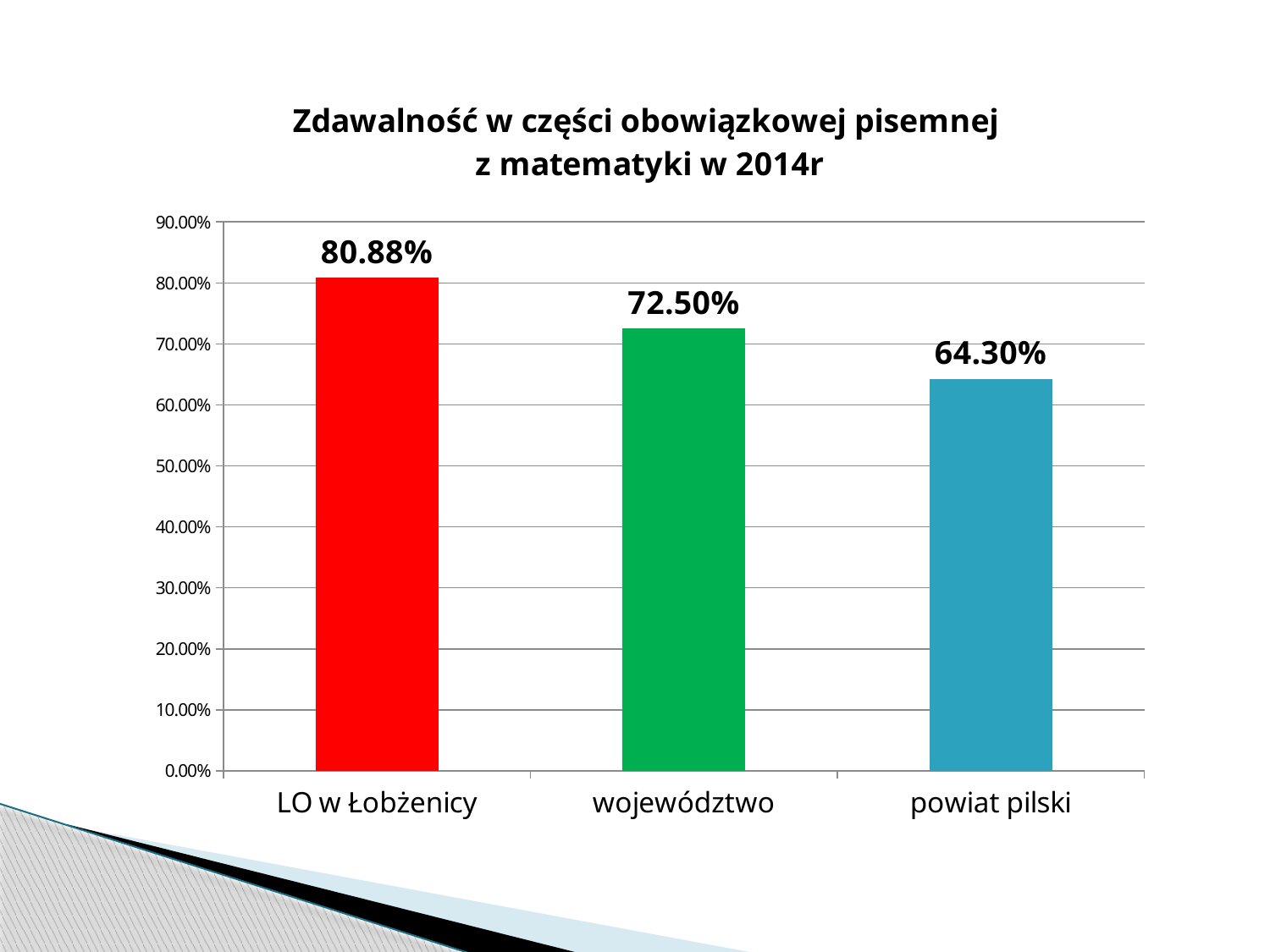
Is the value for województwo greater or less than 70.00%? greater What is the value for województwo? 72.50% Which is larger, the value for województwo or the value for powiat pilski? województwo Which category has the highest value? LO w Łobżenicy What is the difference between the values for województwo and powiat pilski? 8.20% What is the value for LO w Łobżenicy? 80.88% Which category has the lowest value? powiat pilski What is the difference between the values for LO w Łobżenicy and powiat pilski? 16.58% How many categories are shown on the x axis? 3 What kind of chart is shown on the slide? bar chart What is the title of the chart? Zdawalność w części obowiązkowej pisemnej z matematyki w 2014r What is the value for powiat pilski? 64.30%